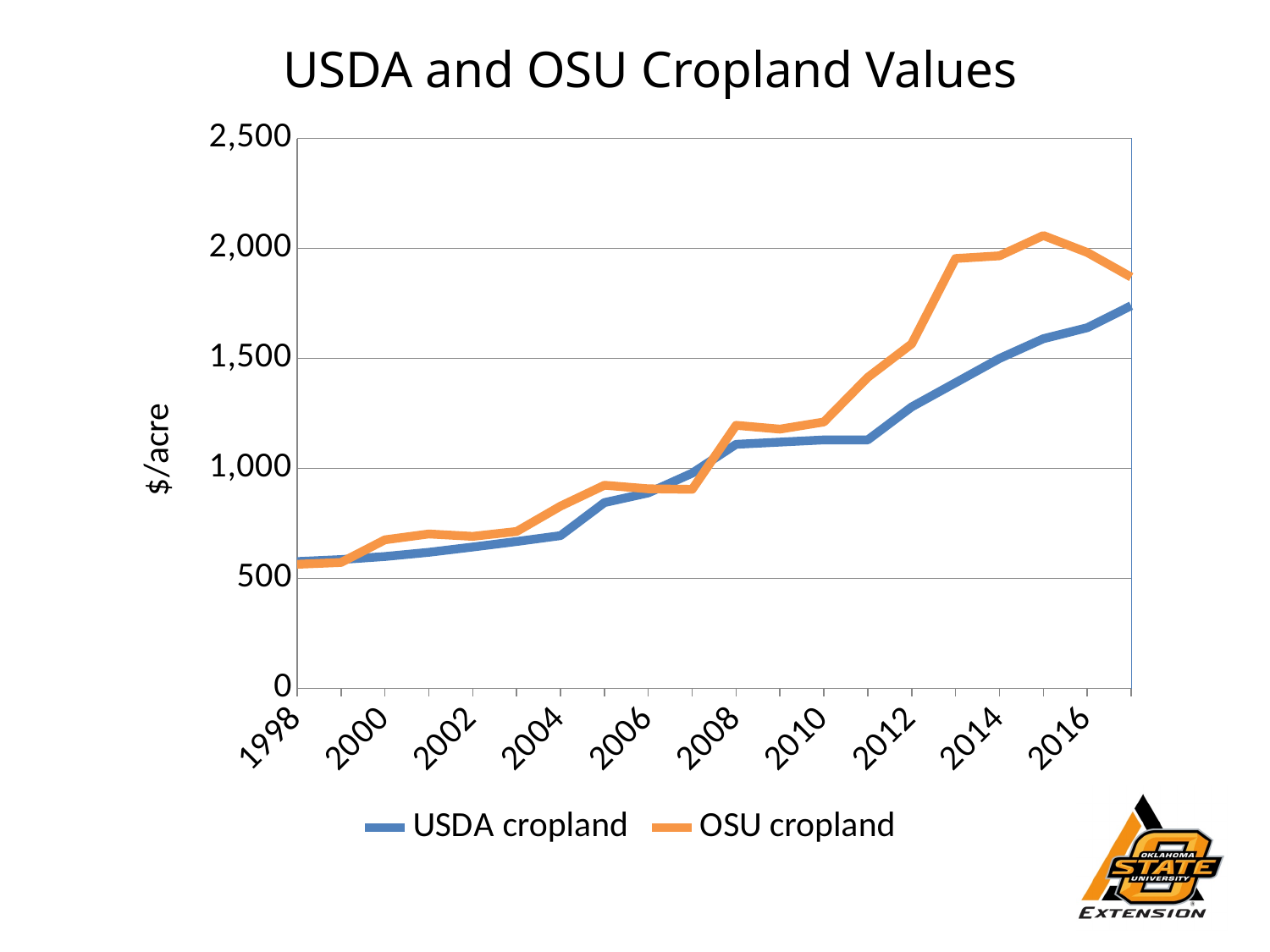
What is the label on the vertical axis? $/acre Is the value for OSU cropland in 2013 greater or less than 1,500? greater In which year does the OSU cropland series reach its highest value? 2015 What kind of chart is shown on the slide? line chart In 2015, which series has the higher value, USDA cropland or OSU cropland? OSU cropland Is the value for OSU cropland in 2015 greater or less than 2,000? greater Is the value for USDA cropland in 2004 greater or less than 1,000? less Does the USDA cropland series generally rise or fall from 1998 to 2017? rise What is the title of the chart? USDA and OSU Cropland Values How many series does the legend list? 2